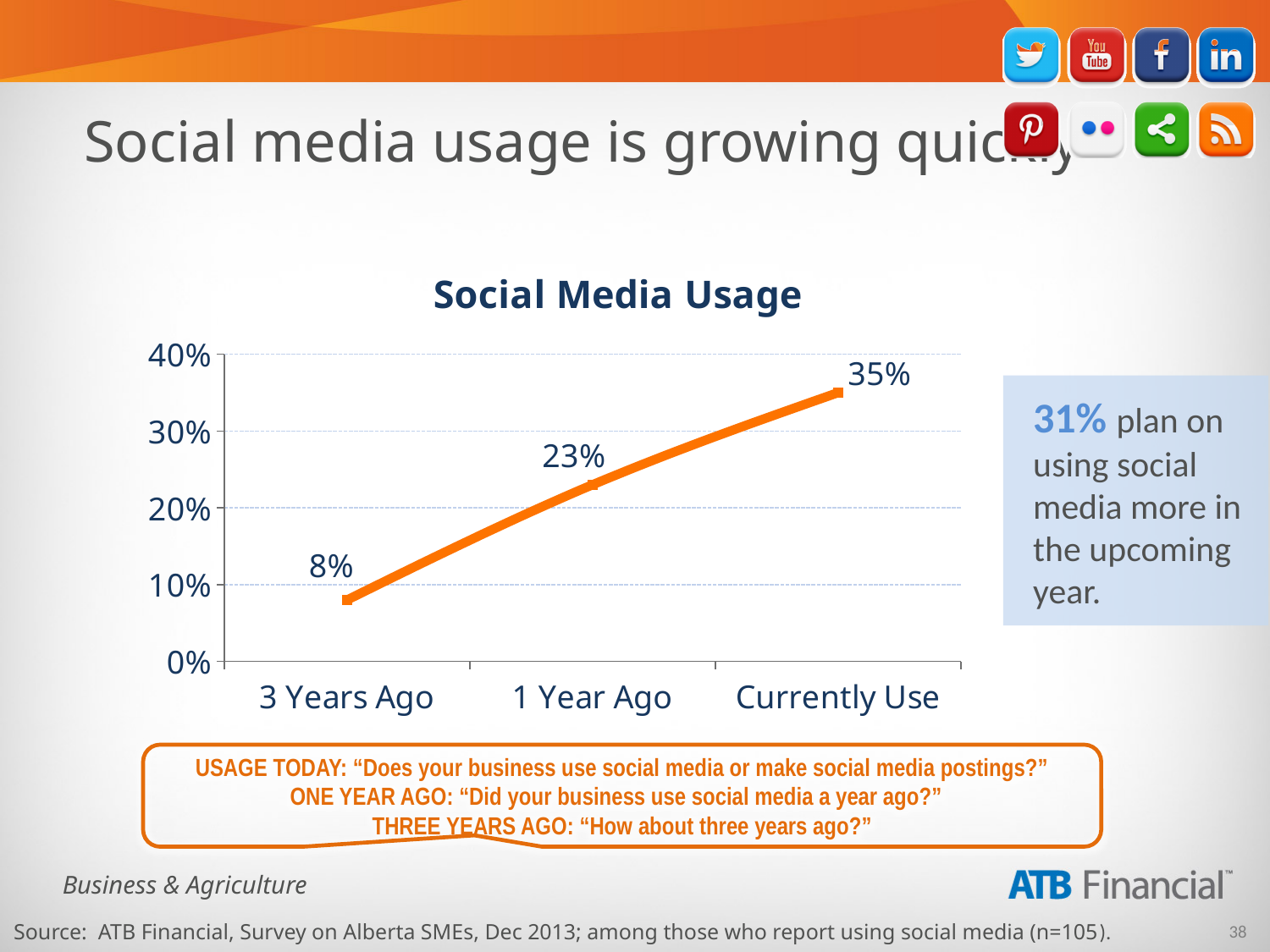
What is the difference between the 1 Year Ago value and the 3 Years Ago value? 15% How many categories are plotted on the x axis? 3 Which category has the highest social media usage? Currently Use Is the value for 1 Year Ago greater or less than 20%? greater What is the difference between the Currently Use value and the 3 Years Ago value? 27% Do the values rise or fall from 3 Years Ago to Currently Use? rise What is the social media usage value for 3 Years Ago? 8% What kind of chart is shown on the slide? line chart Which is larger, the value for 1 Year Ago or the value for Currently Use? Currently Use Which category has the lowest social media usage? 3 Years Ago What is the social media usage value for Currently Use? 35% What is the social media usage value for 1 Year Ago? 23%